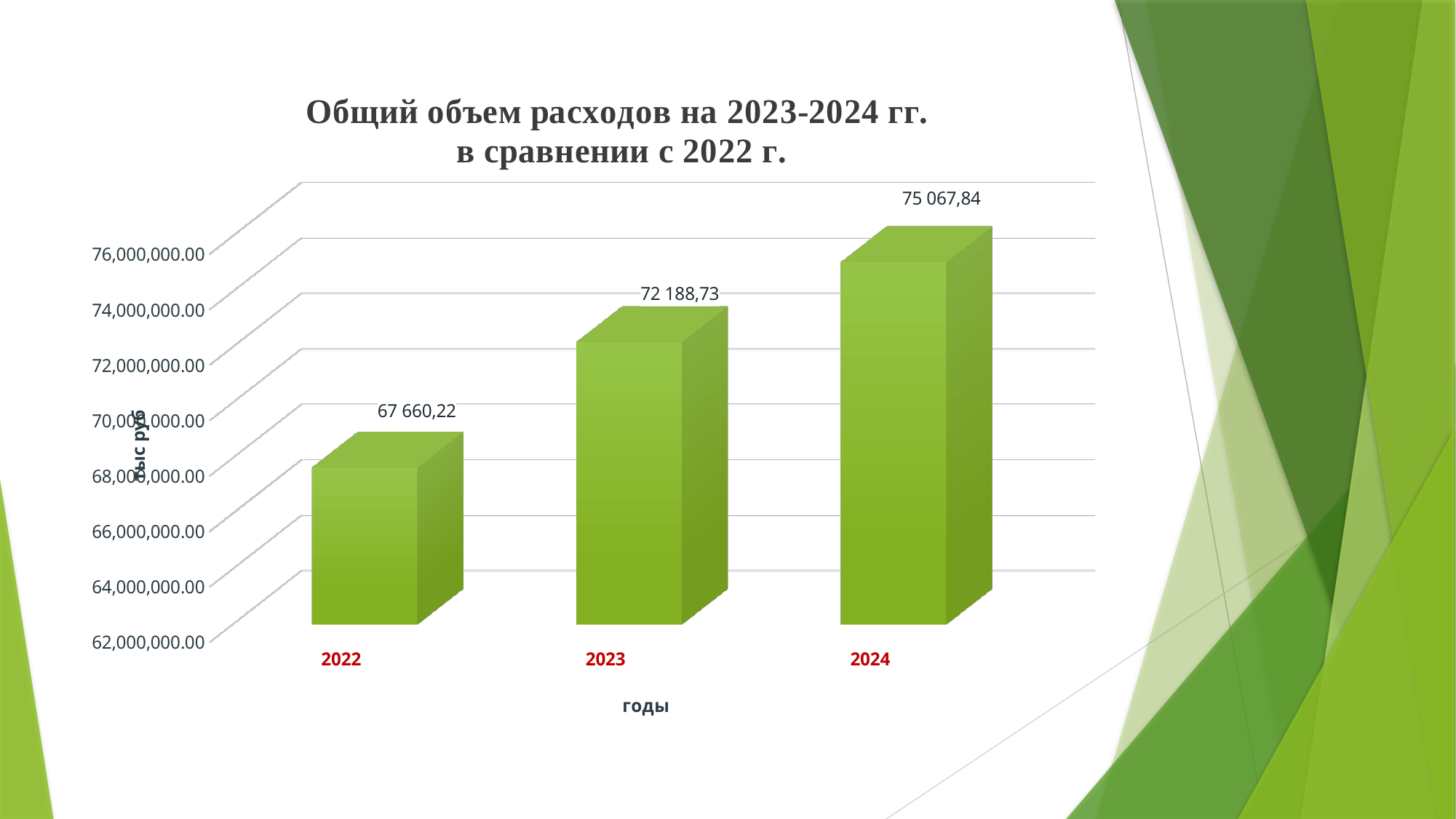
How many years are shown on the x axis? 3 Is the value for 2022 greater or less than 68,000,000.00 on the axis? less What is the value shown for 2023? 72 188,73 Which year has the highest value? 2024 What kind of chart is this? bar chart What is the value shown for 2024? 75 067,84 Which is larger, the value for 2023 or the value for 2024? 2024 What is the difference between the values for 2023 and 2022? 4 528,51 What is the value shown for 2022? 67 660,22 What is the difference between the values for 2024 and 2023? 2 879,11 Do the values rise or fall from 2022 to 2024? rise Which year has the lowest value? 2022